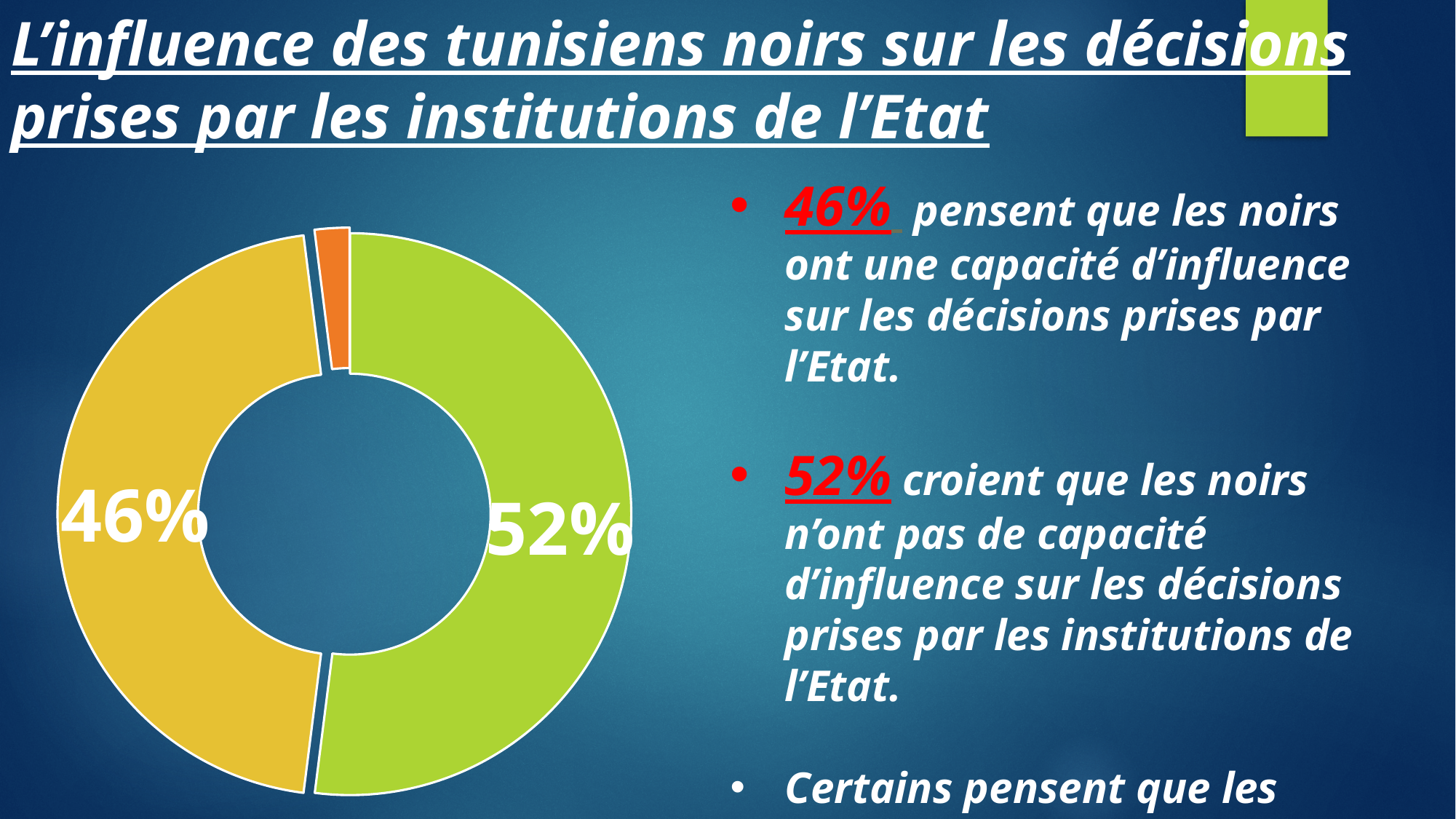
How many slices does the doughnut chart have? 3 Is the value of the green slice greater or less than 50%? greater What value is printed on the green slice of the doughnut chart? 52% Which slice of the doughnut chart is the largest? The green slice (52%) What colour is the slice labelled 46%? Yellow What kind of chart is shown on the slide? Doughnut (pie) chart What value is printed on the yellow slice of the doughnut chart? 46% Which slice of the doughnut chart is the smallest? The orange slice Which is larger, the green slice or the yellow slice? The green slice What is the difference between the green slice (52%) and the yellow slice (46%)? 6 percentage points What share of the doughnut chart does the green slice represent? 52% Is the value of the yellow slice greater or less than 50%? less